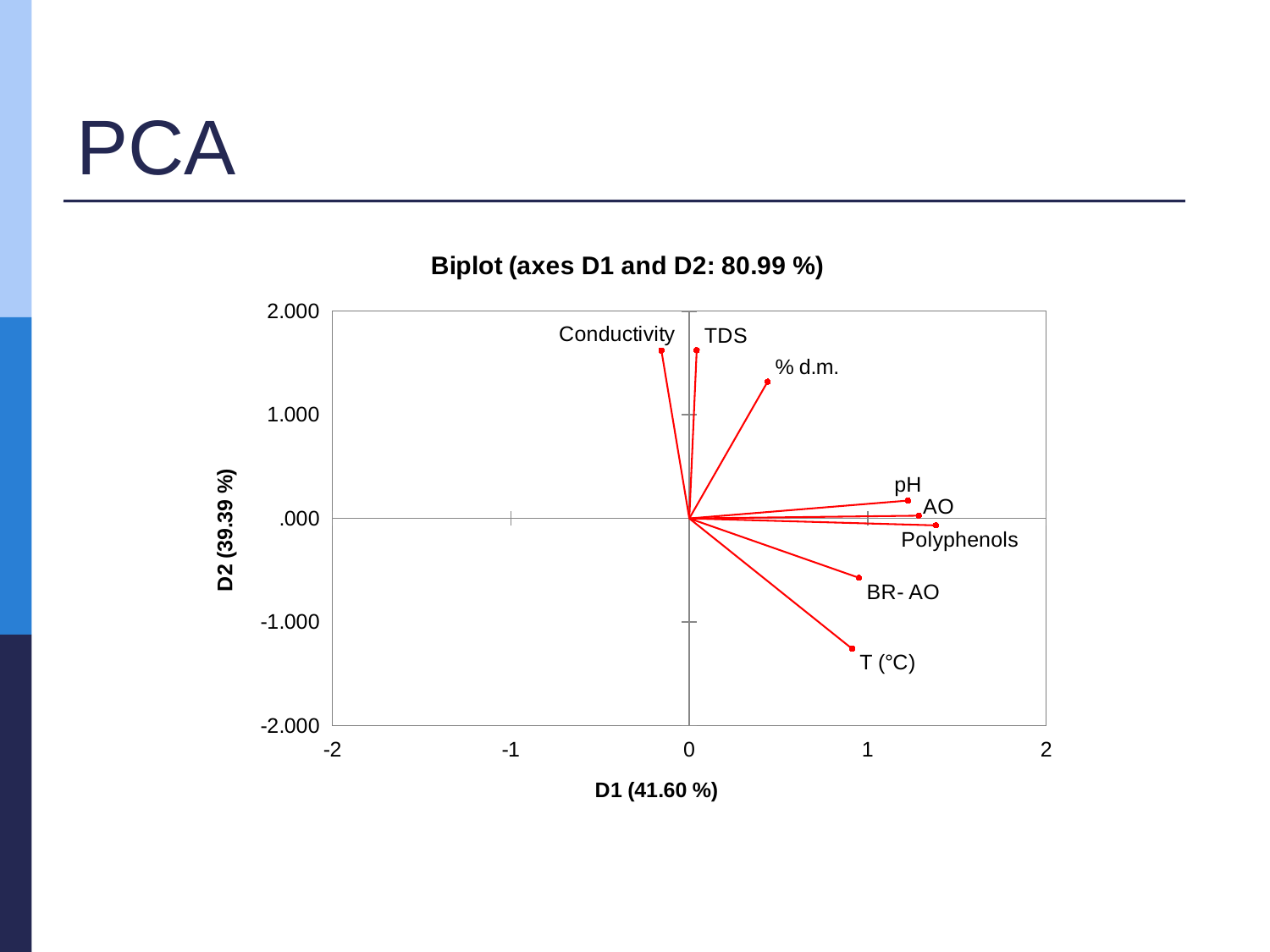
Is the D2 value for BR- AO greater or less than .000? less Which has the higher D2 value, % d.m. or pH? % d.m. What is the title of the chart? Biplot (axes D1 and D2: 80.99 %) Is the D1 value for pH greater or less than 1? greater Which has the lower D2 value, T (°C) or BR- AO? T (°C) Which variable has the lowest value on the D1 axis? Conductivity Is the D2 value for Conductivity greater or less than 1.000? greater How many variable vectors are plotted in the biplot? 8 What is the label of the horizontal axis? D1 (41.60 %) Which variable has the lowest value on the D2 axis? T (°C)